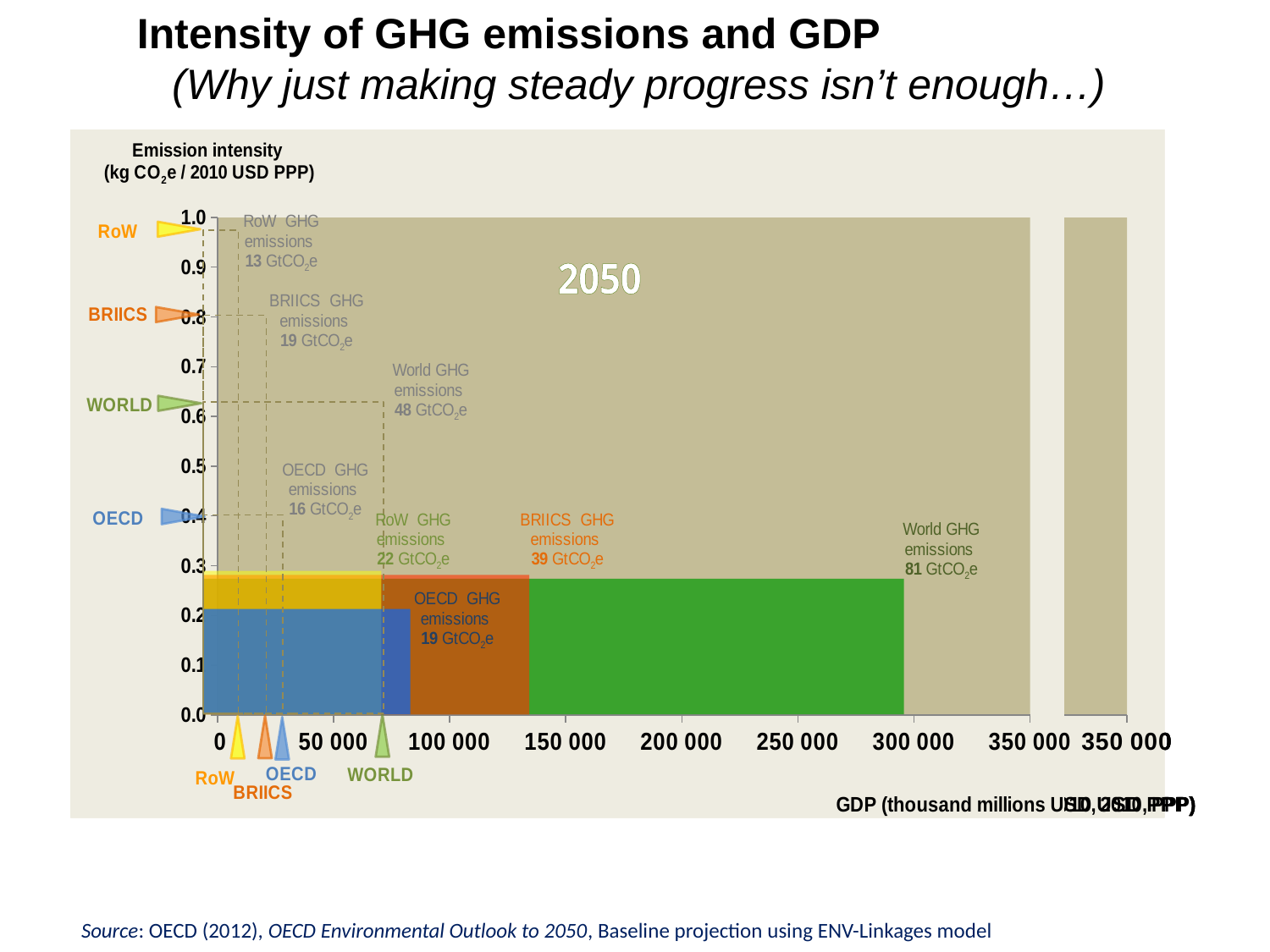
What value is given for World GHG emissions in the grey label near the top of the chart? 48 GtCO2e What value is given for OECD GHG emissions in the 2050 (dark) label inside the orange area? 19 GtCO2e What is the highest tick value shown on the emission intensity (y) axis? 1.0 According to the label on the chart, what are World GHG emissions in 2050? 81 GtCO2e Is the OECD emission intensity marker on the y axis greater or less than 0.5? less By how much do World GHG emissions in the 2050 label (81 GtCO2e) exceed the grey World label (48 GtCO2e)? 33 GtCO2e What is the difference between the BRIICS 2050 label (39 GtCO2e) and the grey BRIICS label (19 GtCO2e)? 20 GtCO2e What value is given for RoW GHG emissions in the 2050 (green) label? 22 GtCO2e What value is given for BRIICS GHG emissions in the 2050 (orange) label? 39 GtCO2e Among RoW, BRIICS and OECD, which region has the highest GHG emissions in the 2050 labels? BRIICS What year is printed in large text inside the chart area? 2050 Which is larger in the 2050 labels: BRIICS GHG emissions or OECD GHG emissions? BRIICS